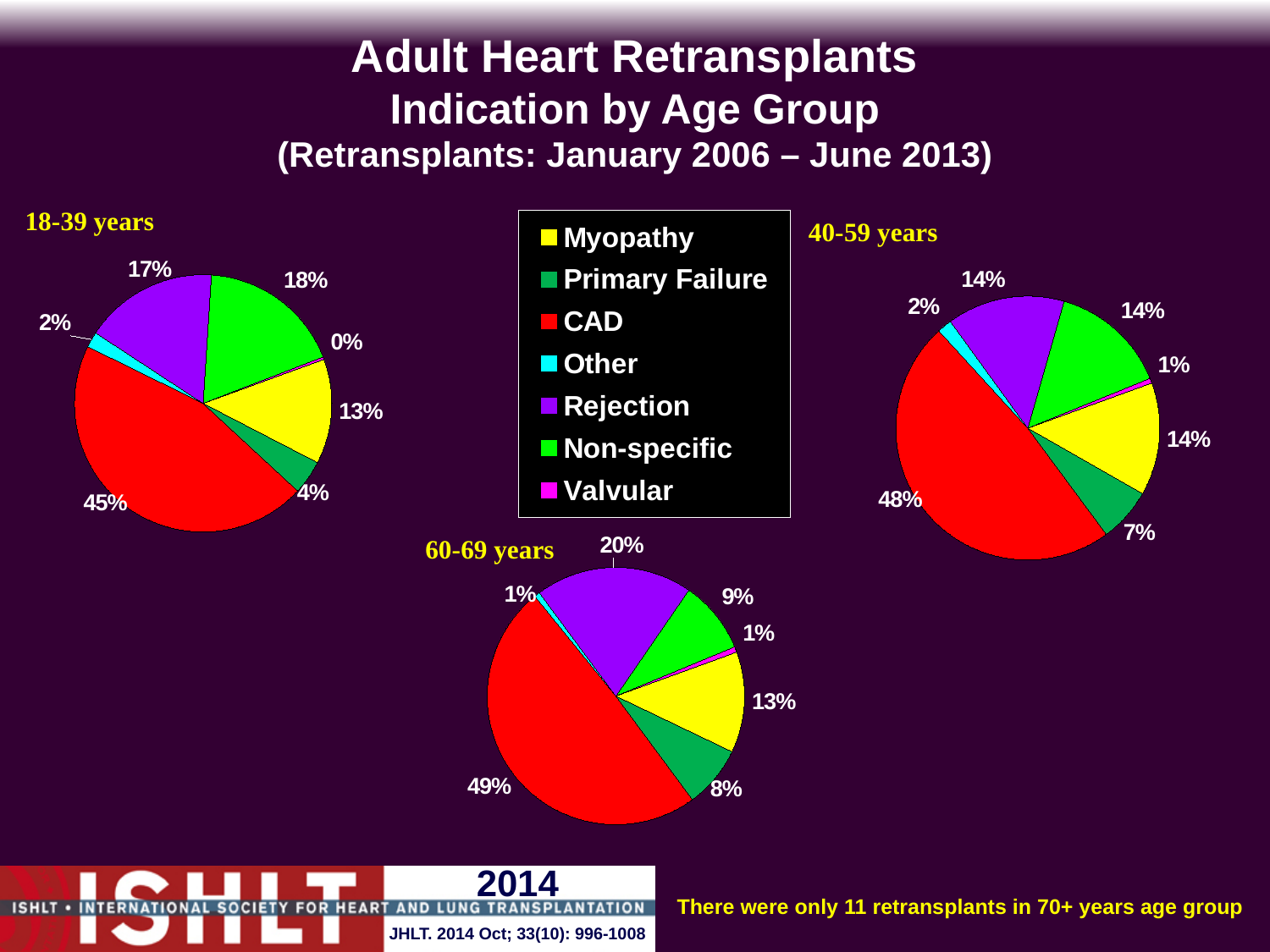
In the 18-39 years pie chart, which indication has the smallest share? Valvular In the 40-59 years pie chart, which indication has the largest share? CAD In the 60-69 years pie chart, what is the difference between the CAD share and the Rejection share? 29% How many pie charts are shown on the slide? 3 What kind of chart is used for the 40-59 years age group? Pie chart In the 60-69 years pie chart, what share is Myopathy? 13% How many series does the legend list? 7 In the 40-59 years pie chart, what share is Primary Failure? 7% What colour represents CAD in the legend? Red In the 60-69 years pie chart, what share is Rejection? 20% In the 18-39 years pie chart, what share is CAD? 45% In the 18-39 years pie chart, which is larger, Non-specific or Rejection? Non-specific